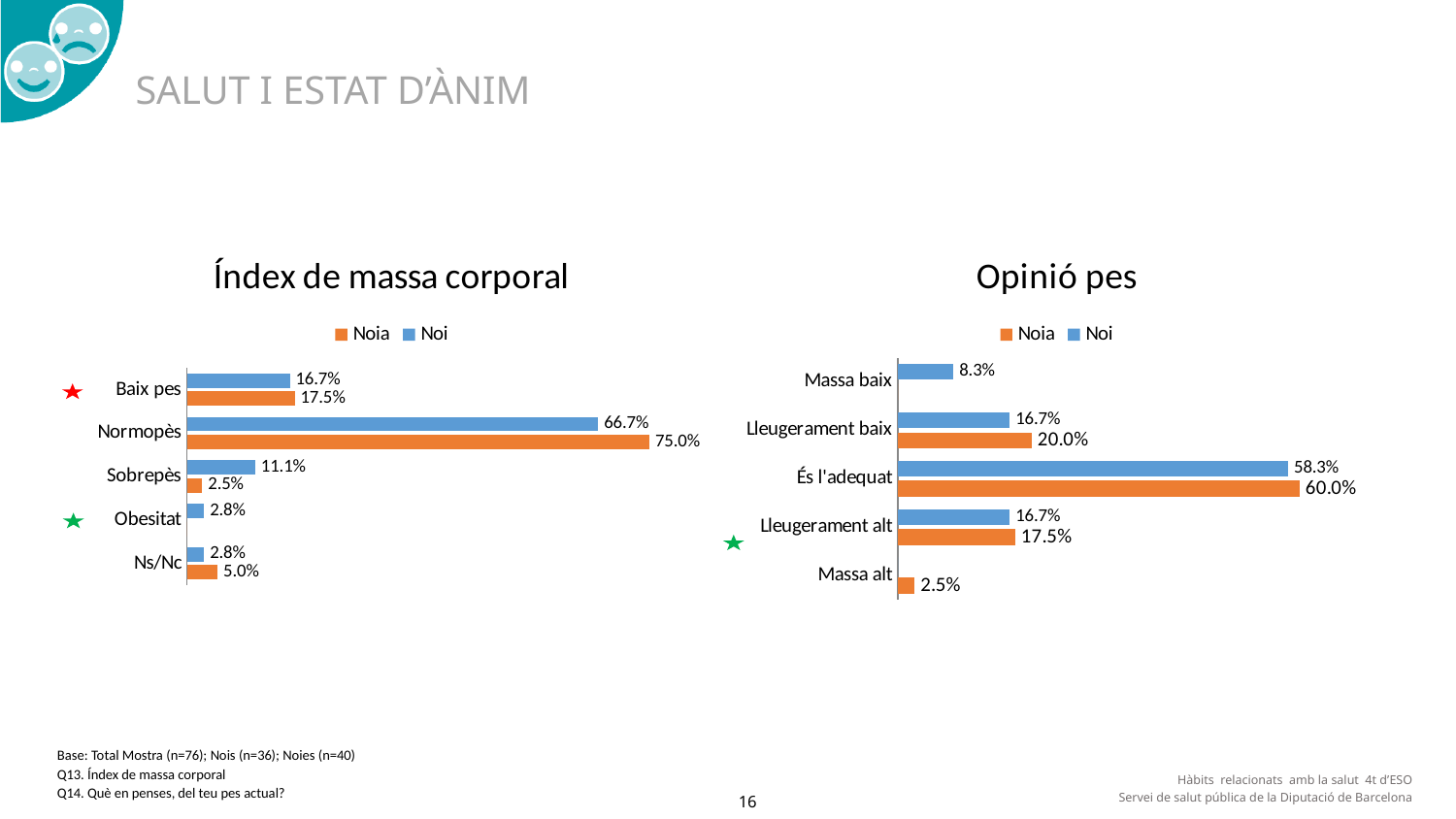
In the 'Opinió pes' chart, what is the difference between the Noia and Noi values for És l'adequat? 1.7% In the 'Índex de massa corporal' chart, which category has the highest Noi value? Normopès In the 'Opinió pes' chart, what is the Noia value for Lleugerament baix? 20.0% In the 'Opinió pes' chart, which category has the highest Noia value? És l'adequat How many categories are shown in the 'Índex de massa corporal' chart? 5 In the 'Índex de massa corporal' chart, what is the Noia value for Normopès? 75.0% In the 'Índex de massa corporal' chart, what is the difference between the Noia and Noi values for Normopès? 8.3% In the 'Índex de massa corporal' chart, which is larger for Sobrepès, the Noi value or the Noia value? Noi In the 'Índex de massa corporal' chart, what is the Noi value for Sobrepès? 11.1% How many series does the legend of the 'Opinió pes' chart list? 2 What type of chart is the 'Opinió pes' chart? Bar chart In the 'Opinió pes' chart, what is the Noi value for Massa baix? 8.3%